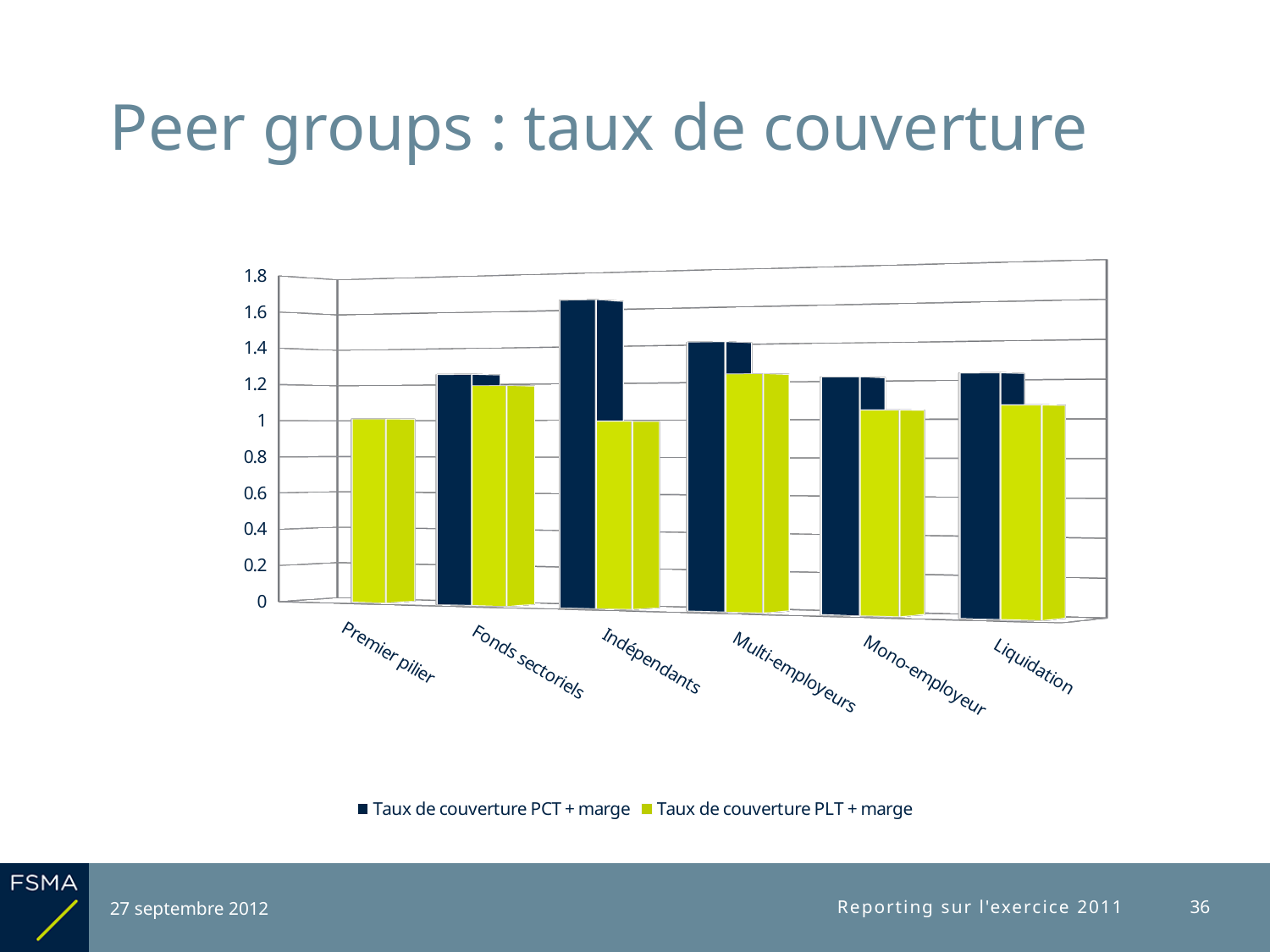
For Indépendants, which series has the larger value: 'Taux de couverture PCT + marge' or 'Taux de couverture PLT + marge'? Taux de couverture PCT + marge Which has the larger value for 'Taux de couverture PCT + marge': Multi-employeurs or Mono-employeur? Multi-employeurs How many categories are shown on the x axis of the chart? 6 What is the title of the slide containing the chart? Peer groups : taux de couverture Is the value of 'Taux de couverture PCT + marge' for Indépendants greater or less than 1.4? greater How many series does the chart's legend list? 2 Is the value of 'Taux de couverture PCT + marge' for Fonds sectoriels greater or less than 1.4? less Which series is shown in dark navy bars in the chart? Taux de couverture PCT + marge Is the value of 'Taux de couverture PLT + marge' for Indépendants greater or less than 1.2? less Which category has the highest value for the series 'Taux de couverture PCT + marge'? Indépendants What kind of chart is shown on the slide? Bar chart